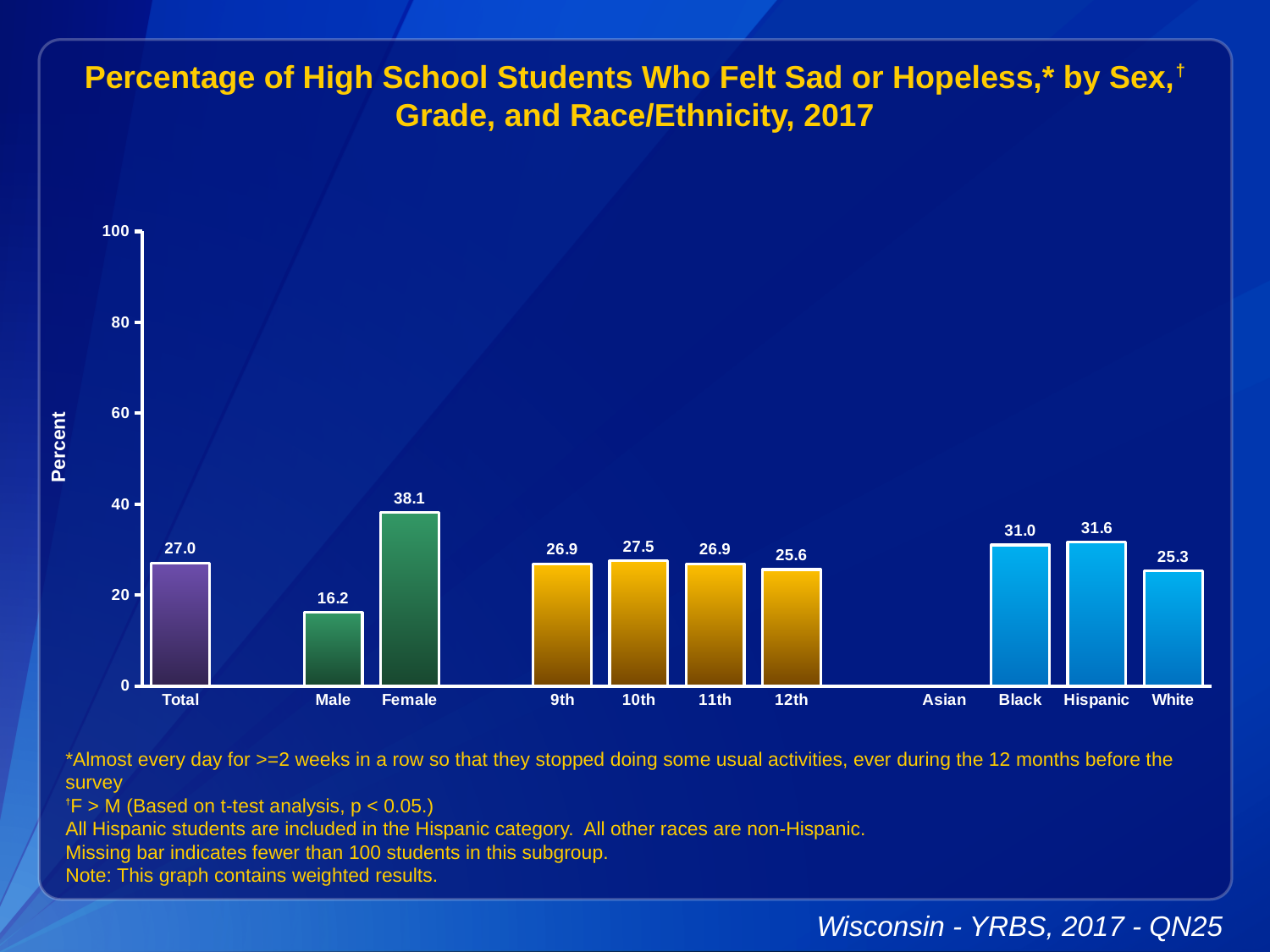
What is the value for Total? 27.0 Which category has the highest value? Female What is the difference between the Female and Male values? 21.9 What is the value for Male? 16.2 Which category label has no bar shown? Asian Is the value for Black greater or less than 20? greater What kind of chart is shown? bar chart Which is larger, the value for 10th or the value for 12th? 10th How many categories have a bar plotted on the chart? 10 What is the value for Hispanic? 31.6 What is the value for Female? 38.1 Which category has the lowest value among the bars shown? Male